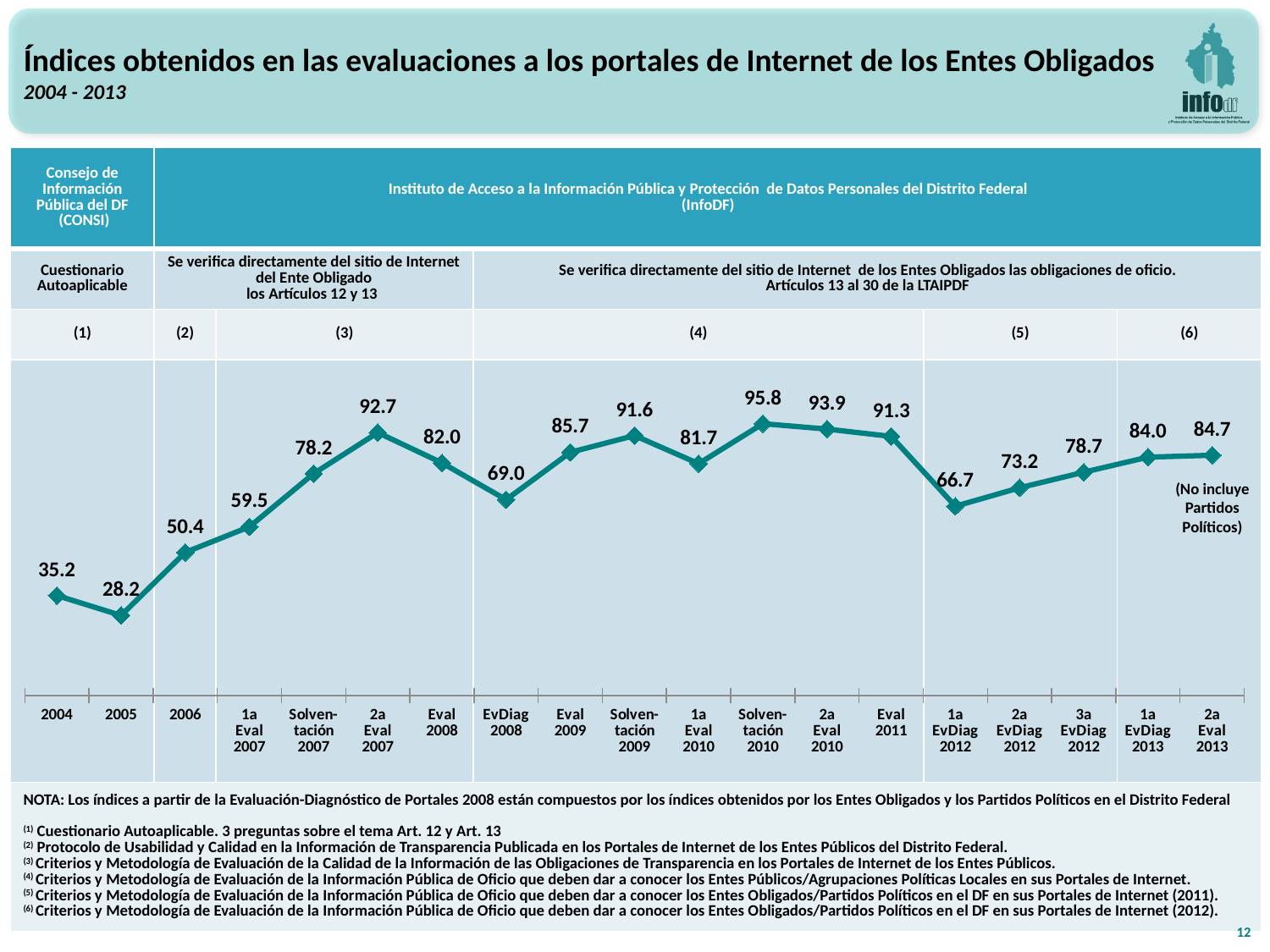
What is the index value for Solventación 2010? 95.8 Which is larger, the index for Eval 2009 or the index for 1a Eval 2010? Eval 2009 What is the index value for 2004? 35.2 What is the difference between the index for 2a Eval 2007 and the index for Eval 2008? 10.7 What is the difference between the index for 2006 and the index for 2005? 22.2 Do the index values rise or fall from 1a EvDiag 2012 to 2a Eval 2013? Rise How many data points are plotted on the chart? 19 Which evaluation has the highest index value? Solventación 2010 Which year or evaluation has the lowest index value? 2005 What is the index value for 1a EvDiag 2012? 66.7 What is the index value for 2a Eval 2013? 84.7 What kind of chart is shown on the slide? Line chart